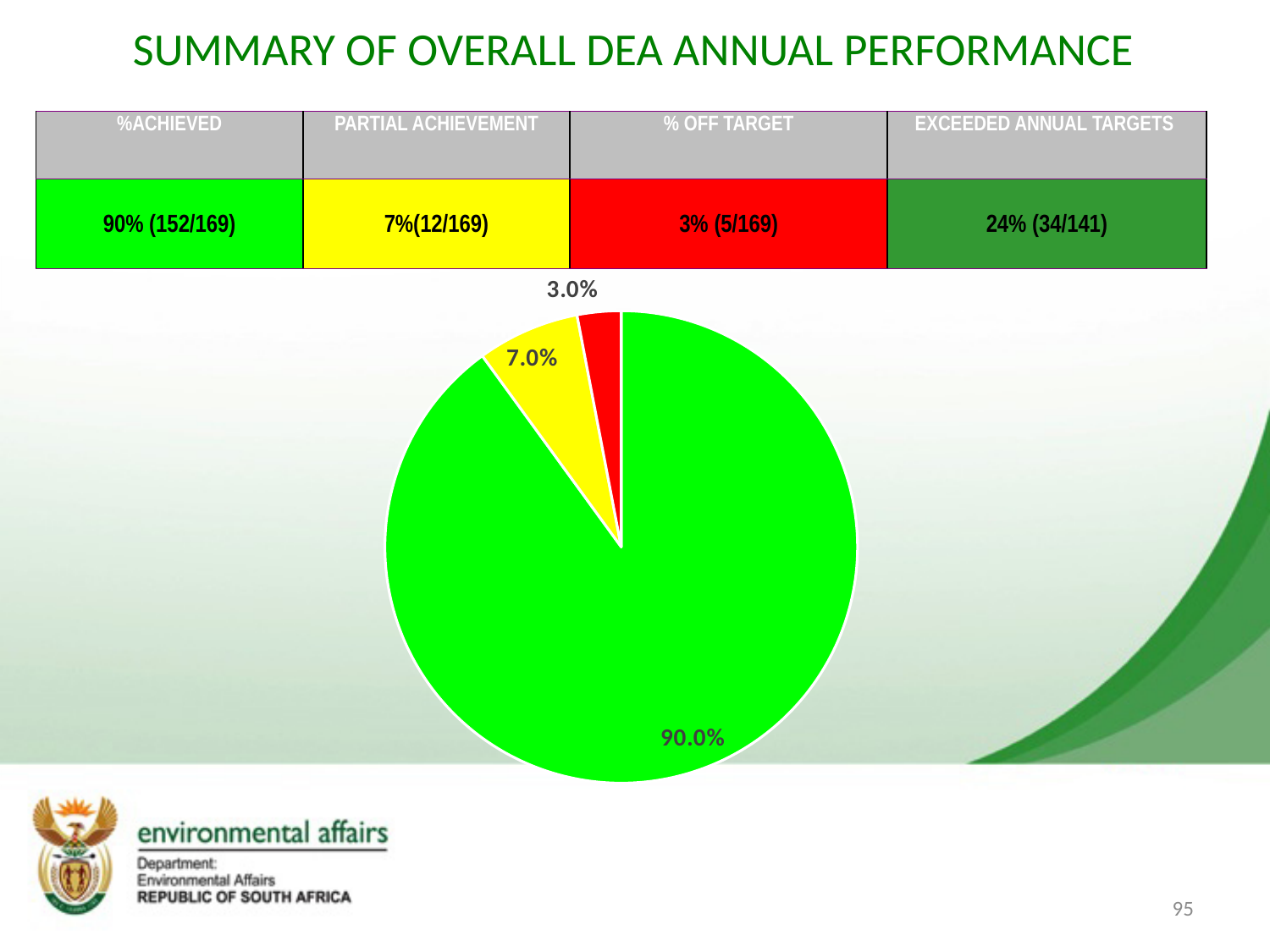
What is the difference between the green slice and the yellow slice in the pie chart? 83.0% How many slices does the pie chart have? 3 Which slice of the pie chart is the smallest? the red slice (3.0%) What percentage is shown on the red slice of the pie chart? 3.0% What percentage is shown on the yellow slice of the pie chart? 7.0% Which slice of the pie chart is the largest? the green slice (90.0%) What is the title of the slide containing the pie chart? SUMMARY OF OVERALL DEA ANNUAL PERFORMANCE What percentage is shown on the green slice of the pie chart? 90.0% What is the difference between the yellow slice and the red slice in the pie chart? 4.0% What share of the pie does the green slice represent? 90.0% What kind of chart is shown on the slide? pie chart Which is larger in the pie chart, the yellow slice or the red slice? the yellow slice